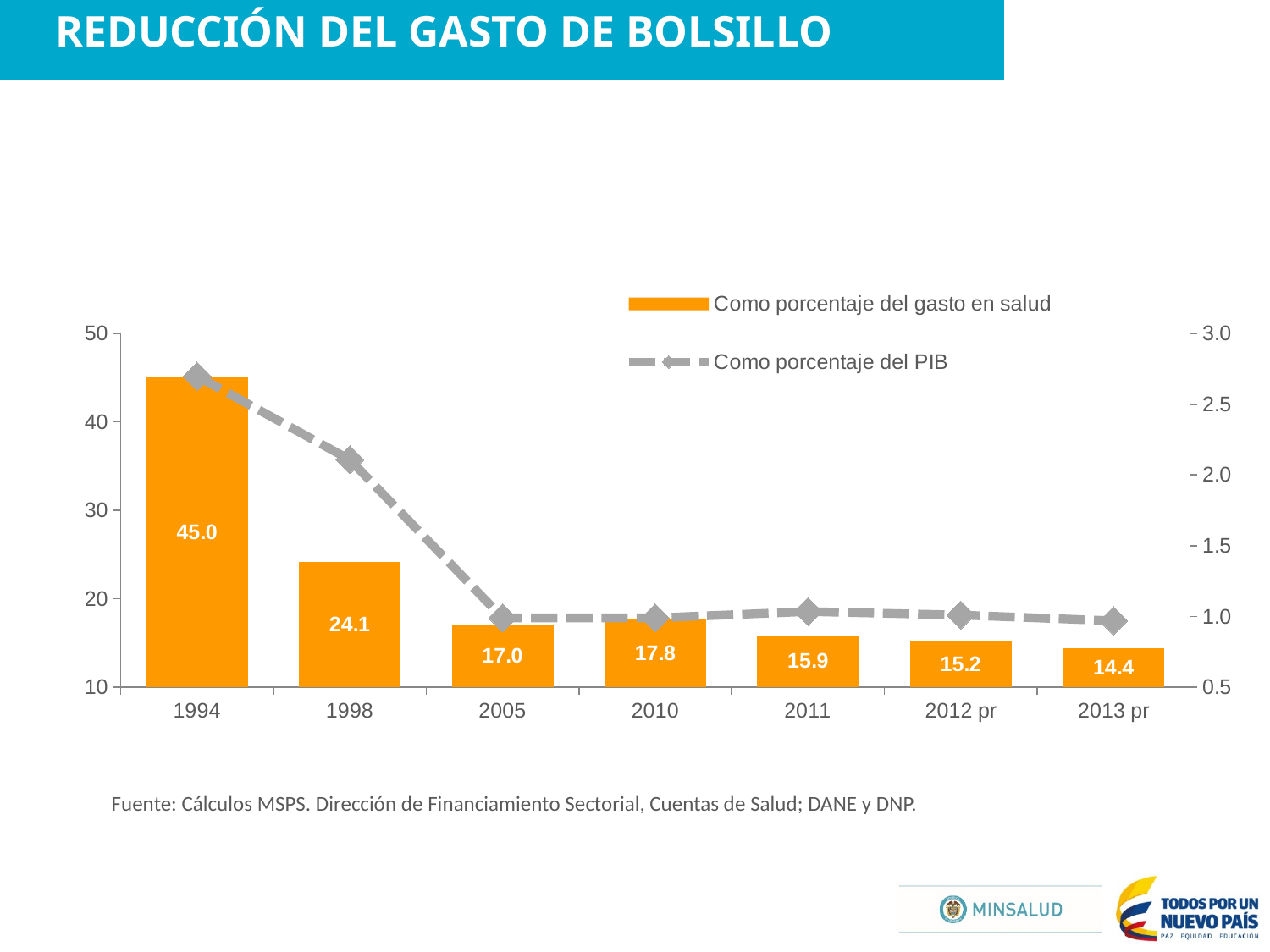
Which is larger for 'Como porcentaje del gasto en salud': 2005 or 2010? 2010 What is the value of 'Como porcentaje del gasto en salud' for 1994? 45.0 How many years are shown on the x axis of the chart? 7 How many series does the legend list? 2 What is the value of 'Como porcentaje del gasto en salud' for 2013 pr? 14.4 Is the value of 'Como porcentaje del PIB' for 2005 greater or less than 1.5? less What is the overall trend of 'Como porcentaje del gasto en salud' from 1994 to 2013 pr? falling What is the value of 'Como porcentaje del gasto en salud' for 2010? 17.8 Which year has the highest value for 'Como porcentaje del gasto en salud'? 1994 What is the difference between the 'Como porcentaje del gasto en salud' values for 1994 and 1998? 20.9 Is the value of 'Como porcentaje del PIB' for 1994 greater or less than 2.5? greater Which year has the lowest value for 'Como porcentaje del gasto en salud'? 2013 pr